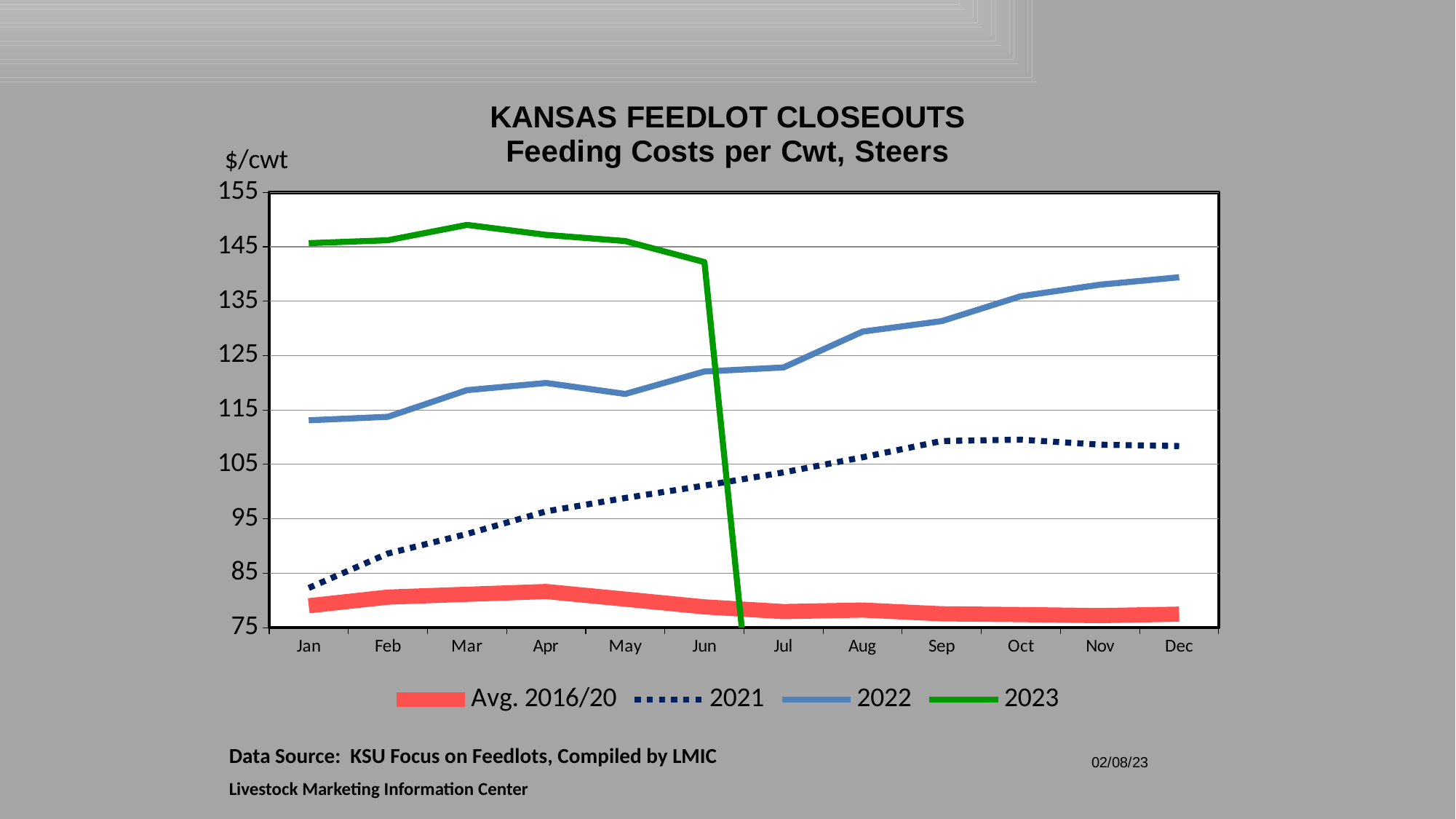
Is the value for 2021 in Jan greater or less than 85? less Which series has the lowest value in Dec? Avg. 2016/20 Is the value for 2022 in Dec greater or less than 135? greater Which series has the highest value in Mar? 2023 How many series does the legend list? 4 Is the value for 2022 in Jan greater or less than 115? less In Jul, which is larger: the value for 2022 or the value for 2021? 2022 What kind of chart is shown on the slide? line chart Does the 2022 line rise or fall from Jul to Dec? rise What unit label is shown above the y axis? $/cwt How many months are shown along the x axis? 12